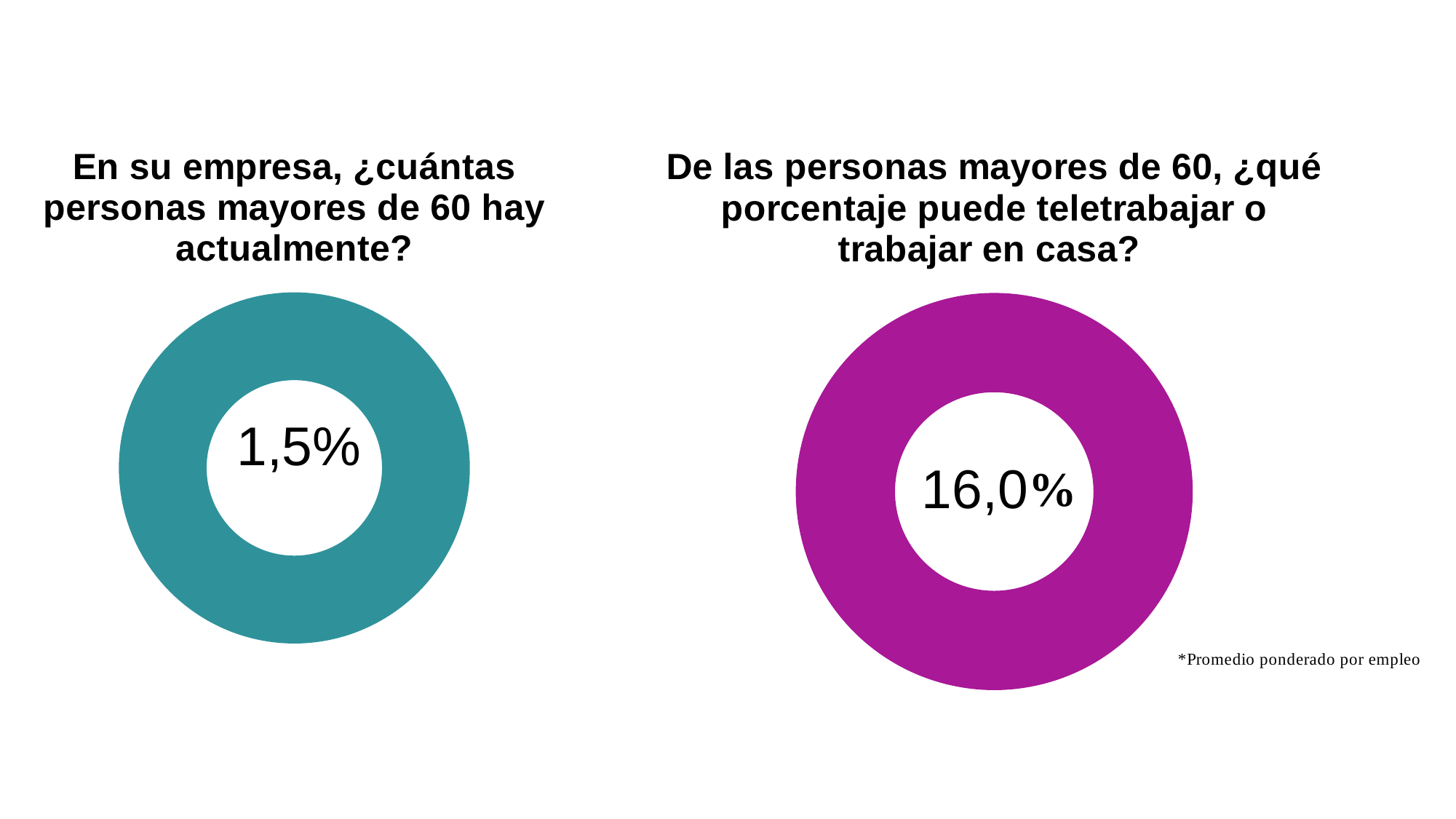
Which chart shows the larger value, the left chart (1,5%) or the right chart (16,0%)? The right chart What colour is the donut ring in the right chart? Magenta/purple What kind of chart is used on the right side of the slide? Donut chart What is the difference between the value in the right chart (16,0%) and the value in the left chart (1,5%)? 14,5% In the right chart ("De las personas mayores de 60, ¿qué porcentaje puede teletrabajar o trabajar en casa?"), what value is shown in the centre of the donut? 16,0% What colour is the donut ring in the left chart? Teal How many donut charts are shown on the slide? 2 What kind of chart is used on the left side of the slide? Donut chart In the left chart ("En su empresa, ¿cuántas personas mayores de 60 hay actualmente?"), what value is shown in the centre of the donut? 1,5%